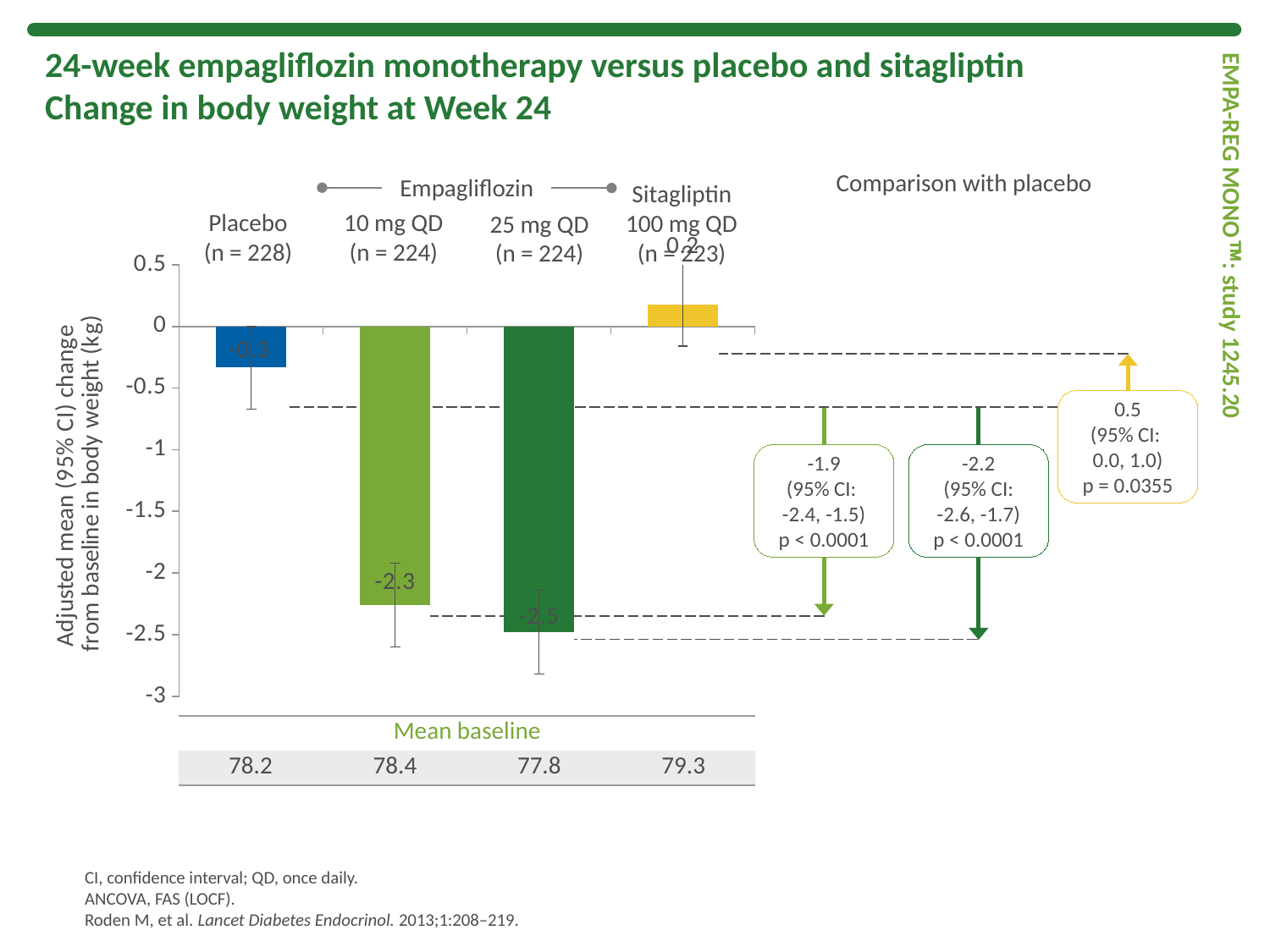
What is the adjusted mean change in body weight for the empagliflozin 10 mg QD group? -2.3 What is the difference between the body weight change for empagliflozin 25 mg QD and empagliflozin 10 mg QD? 0.2 What is the adjusted mean change in body weight for the sitagliptin 100 mg QD group? 0.2 What kind of chart is shown on the slide? Bar chart How many treatment groups are plotted in the chart? 4 Which group has a larger reduction in body weight, placebo or empagliflozin 10 mg QD? Empagliflozin 10 mg QD Which treatment group is the only one with an increase in body weight? Sitagliptin 100 mg QD Which treatment group shows the largest reduction in body weight? Empagliflozin 25 mg QD What is the adjusted mean change in body weight for the empagliflozin 25 mg QD group? -2.5 What is the mean baseline body weight for the sitagliptin 100 mg QD group? 79.3 What is the comparison with placebo value for the empagliflozin 25 mg QD group? -2.2 Is the value for the empagliflozin 25 mg QD group greater or less than -2? less